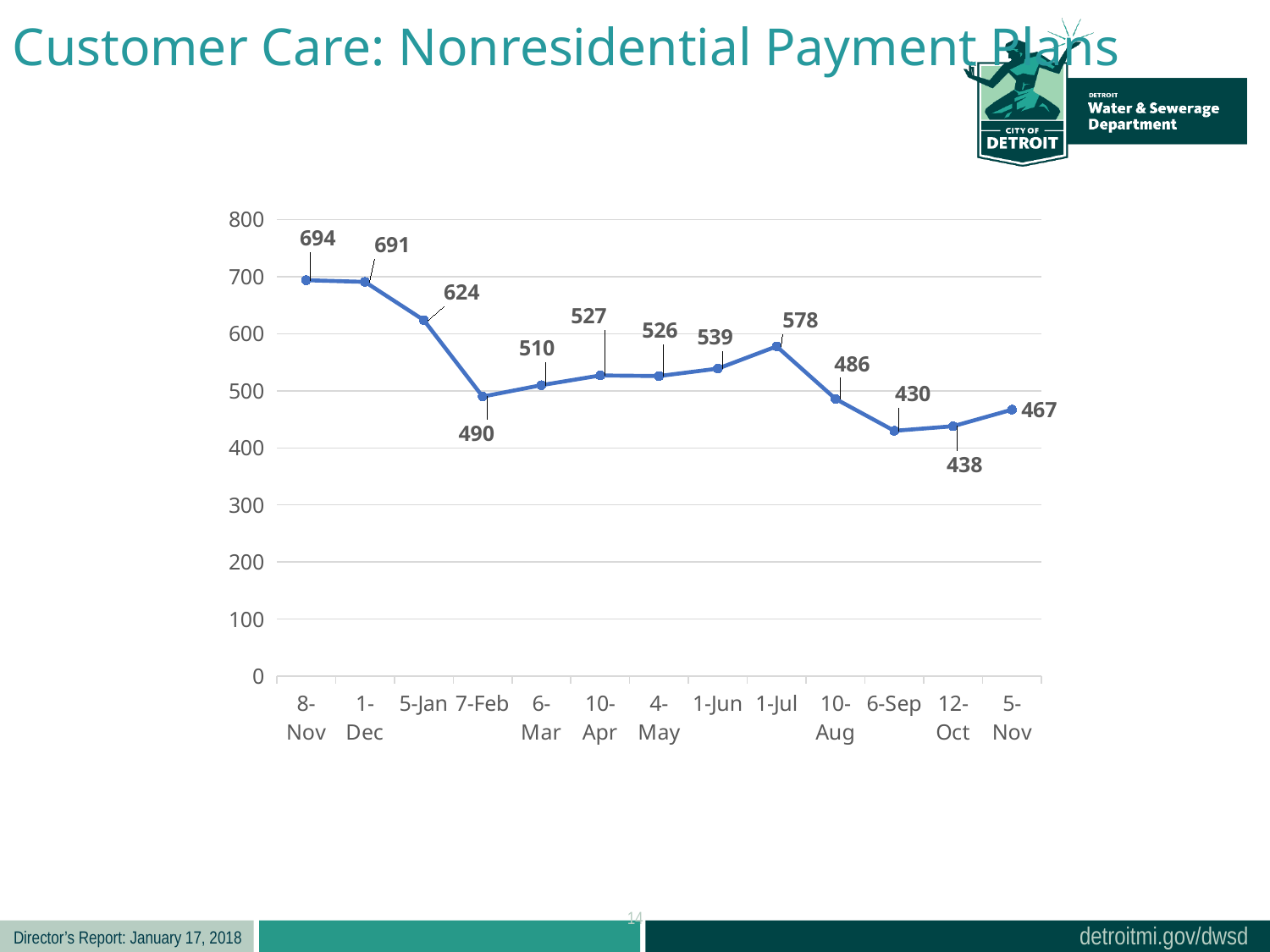
What is the value for 1-Jul? 578 Do the values rise or fall from 8-Nov to 7-Feb? Fall What is the value for 7-Feb? 490 Which date has the highest value? 8-Nov How many data points are plotted on the chart? 13 What is the difference between the values for 5-Jan and 7-Feb? 134 Is the value for 1-Jun greater or less than 500? greater What kind of chart is shown on the slide? Line chart Which is larger, the value for 10-Aug or the value for 12-Oct? 10-Aug Which date has the lowest value? 6-Sep What is the value for 8-Nov? 694 What is the value for 5-Nov? 467